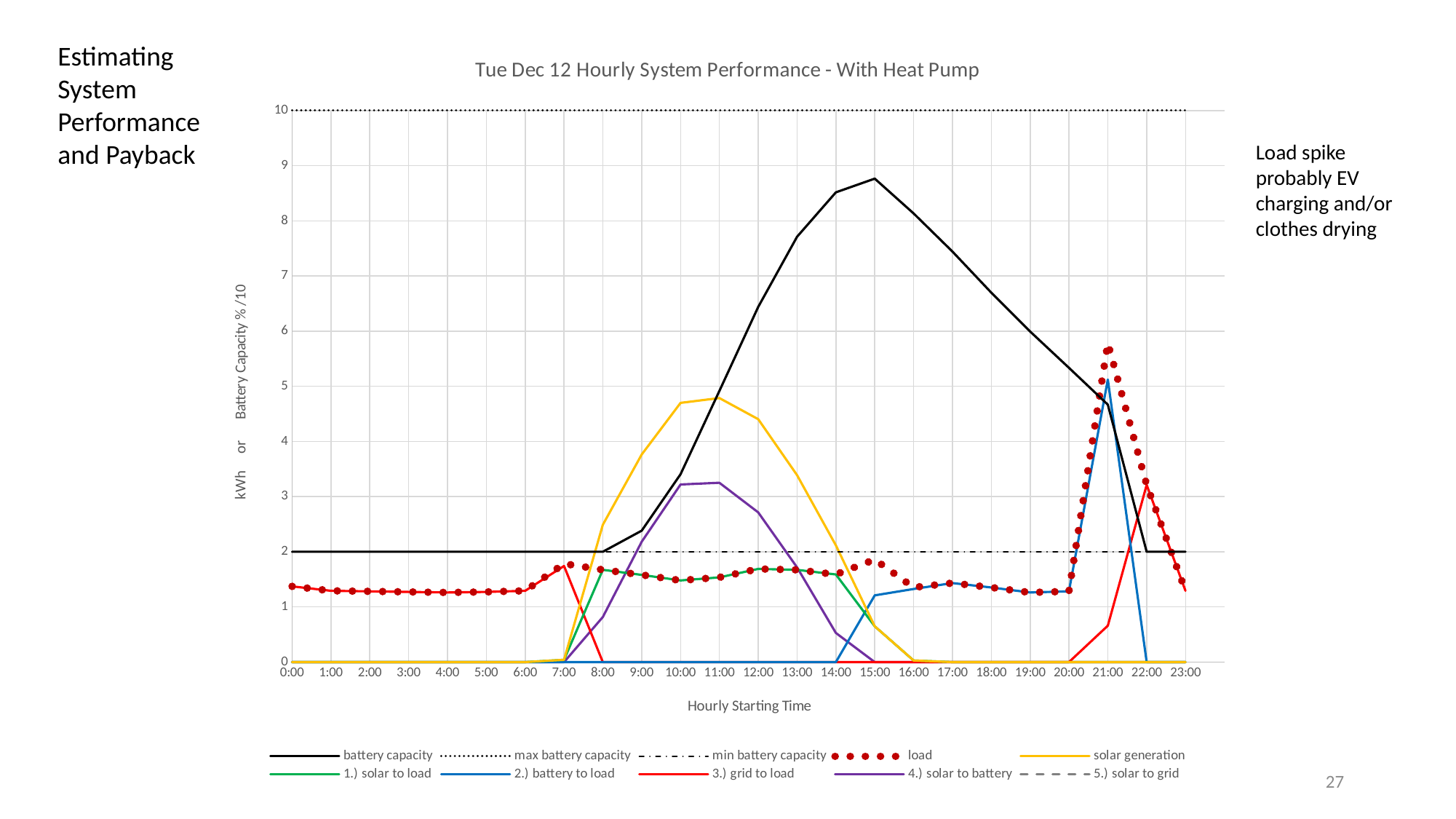
Does the battery capacity rise or fall between 15:00 and 22:00? fall How many hourly points are shown along the x axis? 24 Is the solar generation value at 11:00 greater or less than 4? greater What value does the max battery capacity line sit at? 10 What kind of chart is shown on the slide? line chart What is the title of the chart? Tue Dec 12 Hourly System Performance - With Heat Pump At which hour does battery capacity reach its highest value? 15:00 Is the battery capacity value at 15:00 greater or less than 8? greater How many series does the chart legend list? 10 What value does the min battery capacity line sit at? 2 At which hour is the load highest? 21:00 What is the battery capacity value at 0:00? 2